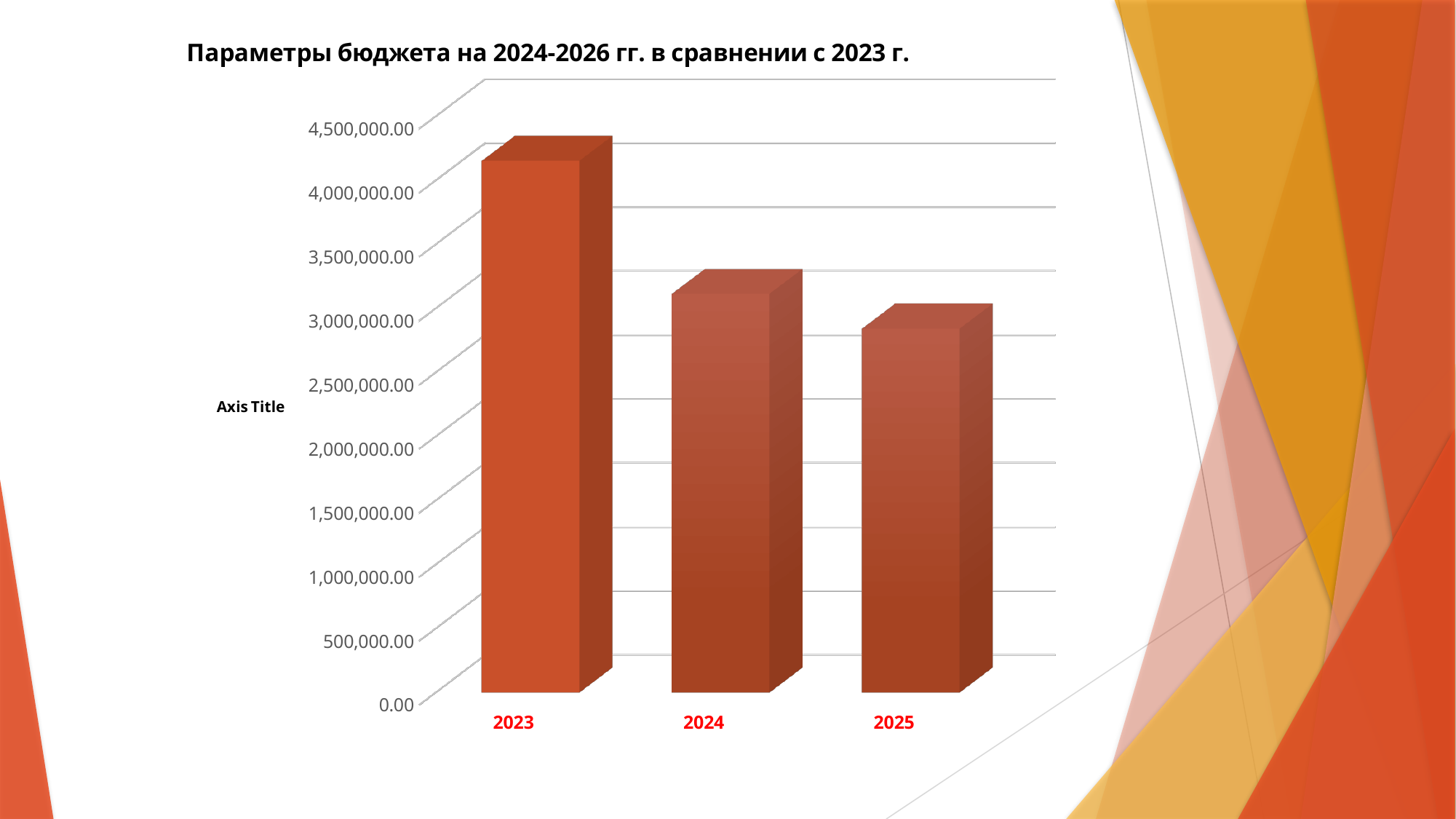
Is the value for 2024 greater or less than 2,500,000.00? greater Which is larger, the value for 2024 or the value for 2025? 2024 What is the title of the chart? Параметры бюджета на 2024-2026 гг. в сравнении с 2023 г. Do the values rise or fall from 2023 to 2025? Fall What is the highest value shown on the vertical axis? 4,500,000.00 What kind of chart is shown on the slide? Bar chart Which year has the highest bar? 2023 Which year has the lowest bar? 2025 Is the value for 2025 greater or less than 3,500,000.00? less Is the value for 2024 greater or less than 3,500,000.00? less How many categories (years) are plotted on the chart? 3